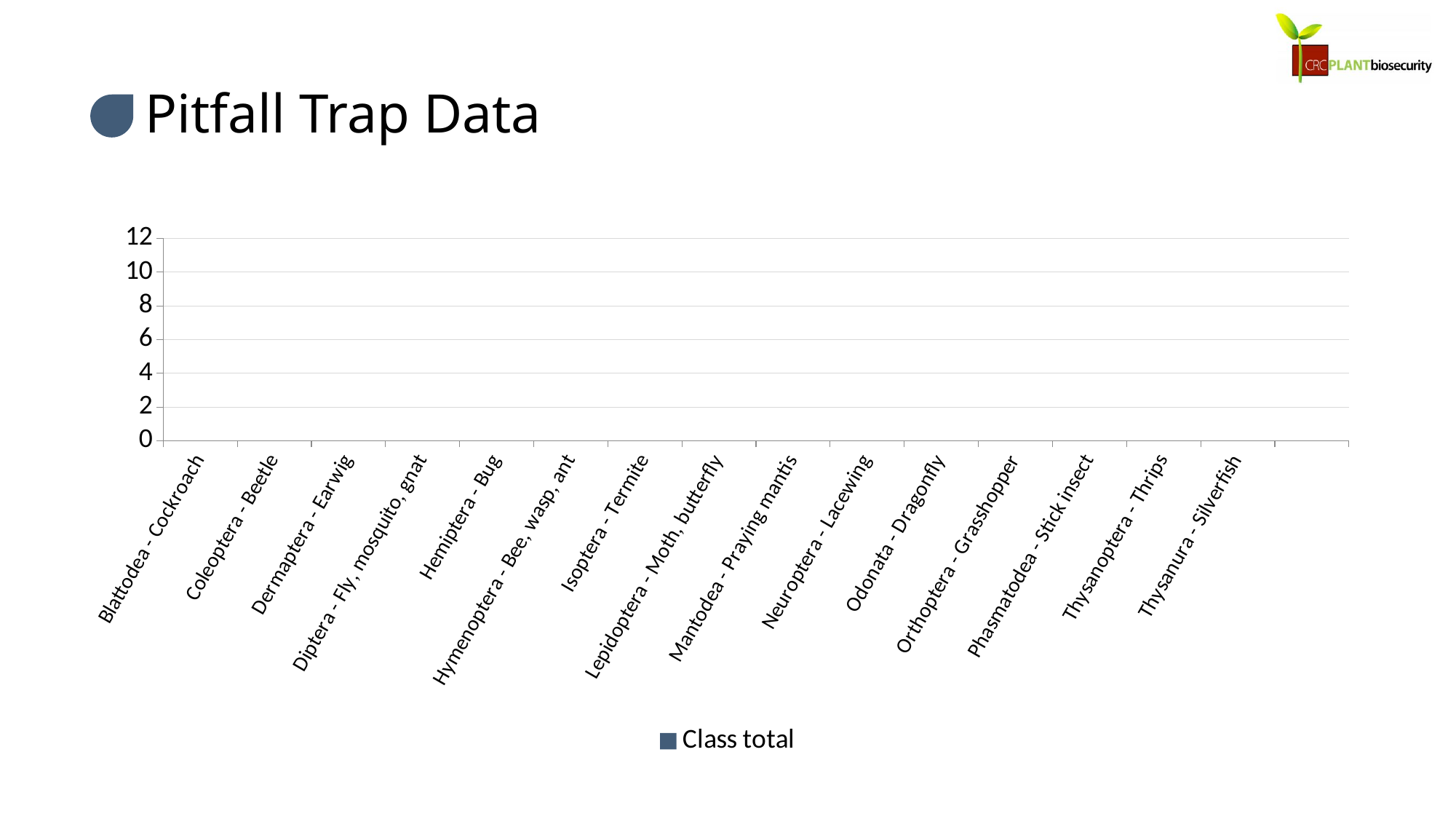
Which category is labelled last (rightmost) on the x axis? Thysanura - Silverfish What is the highest value shown on the chart's y axis? 12 How many series does the chart's legend list? 1 Which category is labelled first (leftmost) on the x axis? Blattodea - Cockroach What is the name of the series shown in the chart's legend? Class total How many labelled categories appear on the x axis of the chart? 15